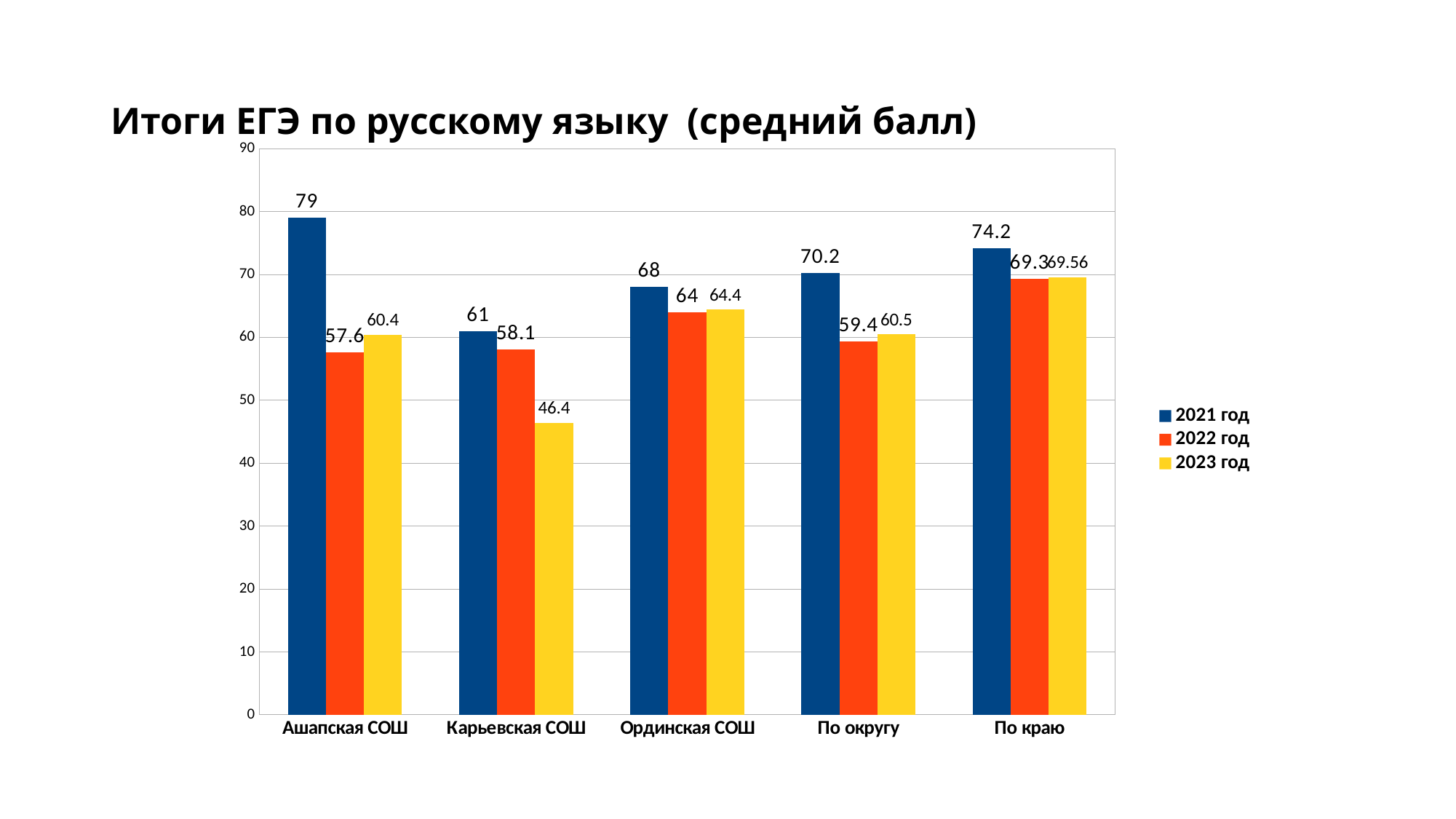
What is the value for Ашапская СОШ in the 2021 год series? 79 Which category has the highest value in the 2021 год series? Ашапская СОШ Which is larger for Ординская СОШ: the 2022 год value or the 2023 год value? 2023 год Which category has the lowest value in the 2023 год series? Карьевская СОШ What is the value for По краю in the 2023 год series? 69.56 What is the title of the chart? Итоги ЕГЭ по русскому языку (средний балл) What is the difference between the 2021 год and 2022 год values for Ашапская СОШ? 21.4 What is the value for По округу in the 2022 год series? 59.4 What kind of chart is shown on the slide? Bar chart What is the value for Карьевская СОШ in the 2023 год series? 46.4 How many categories are shown on the x axis? 5 How many series does the legend list? 3